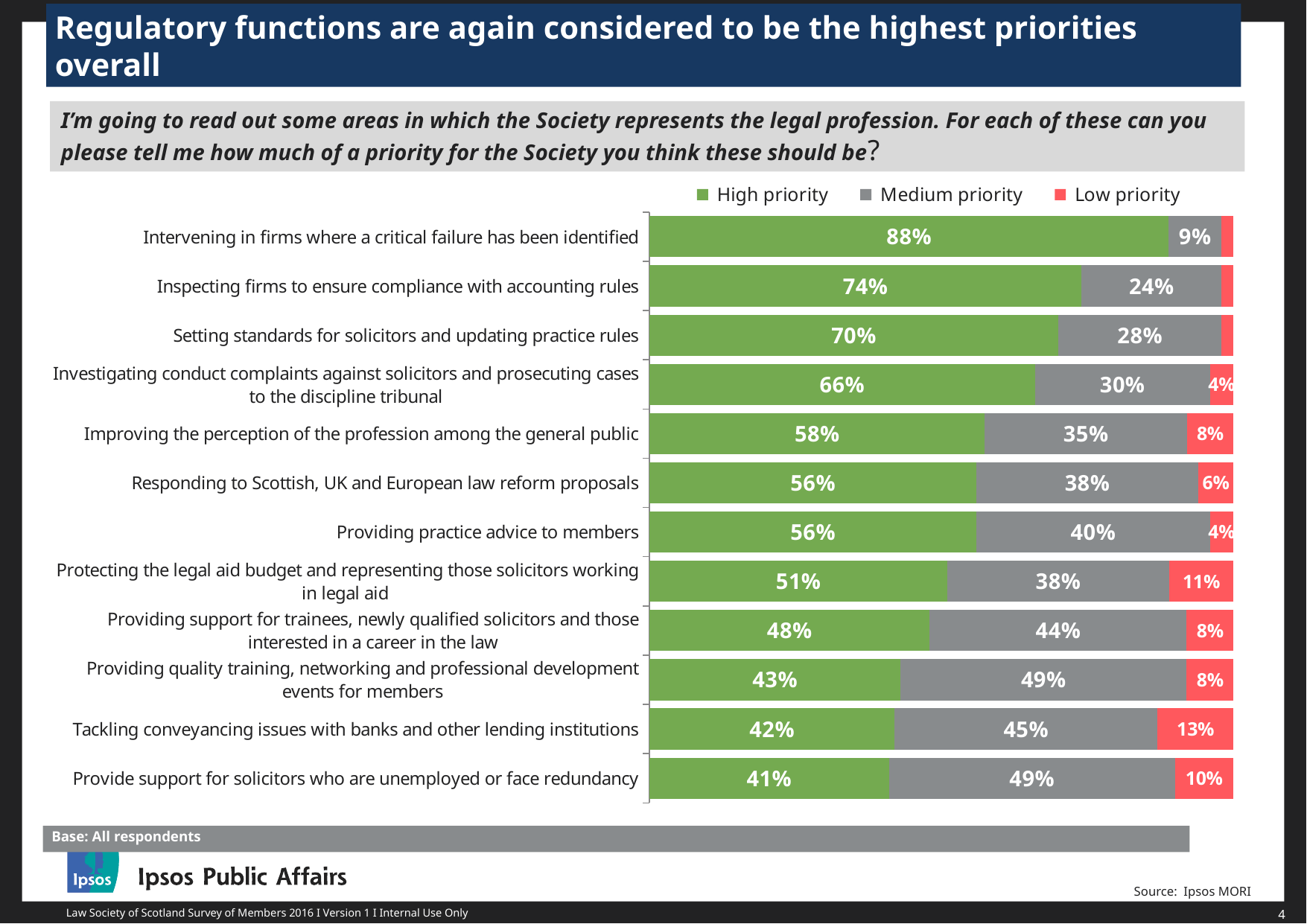
Which has a larger medium priority value: 'Providing quality training, networking and professional development events for members' or 'Tackling conveyancing issues with banks and other lending institutions'? Providing quality training, networking and professional development events for members How many series does the legend list? 3 What percentage rated 'Intervening in firms where a critical failure has been identified' as a high priority? 88% Which area has the lowest high priority percentage? Provide support for solicitors who are unemployed or face redundancy How many areas (categories) are shown in the chart? 12 Which colour represents 'Low priority' in the legend? Red Which area has the highest high priority percentage? Intervening in firms where a critical failure has been identified What kind of chart is shown on the slide? Stacked bar chart What is the low priority value for 'Protecting the legal aid budget and representing those solicitors working in legal aid'? 11% What is the difference in high priority percentage between 'Intervening in firms where a critical failure has been identified' and 'Inspecting firms to ensure compliance with accounting rules'? 14 percentage points What is the medium priority value for 'Providing practice advice to members'? 40% Which area has the highest low priority percentage? Tackling conveyancing issues with banks and other lending institutions